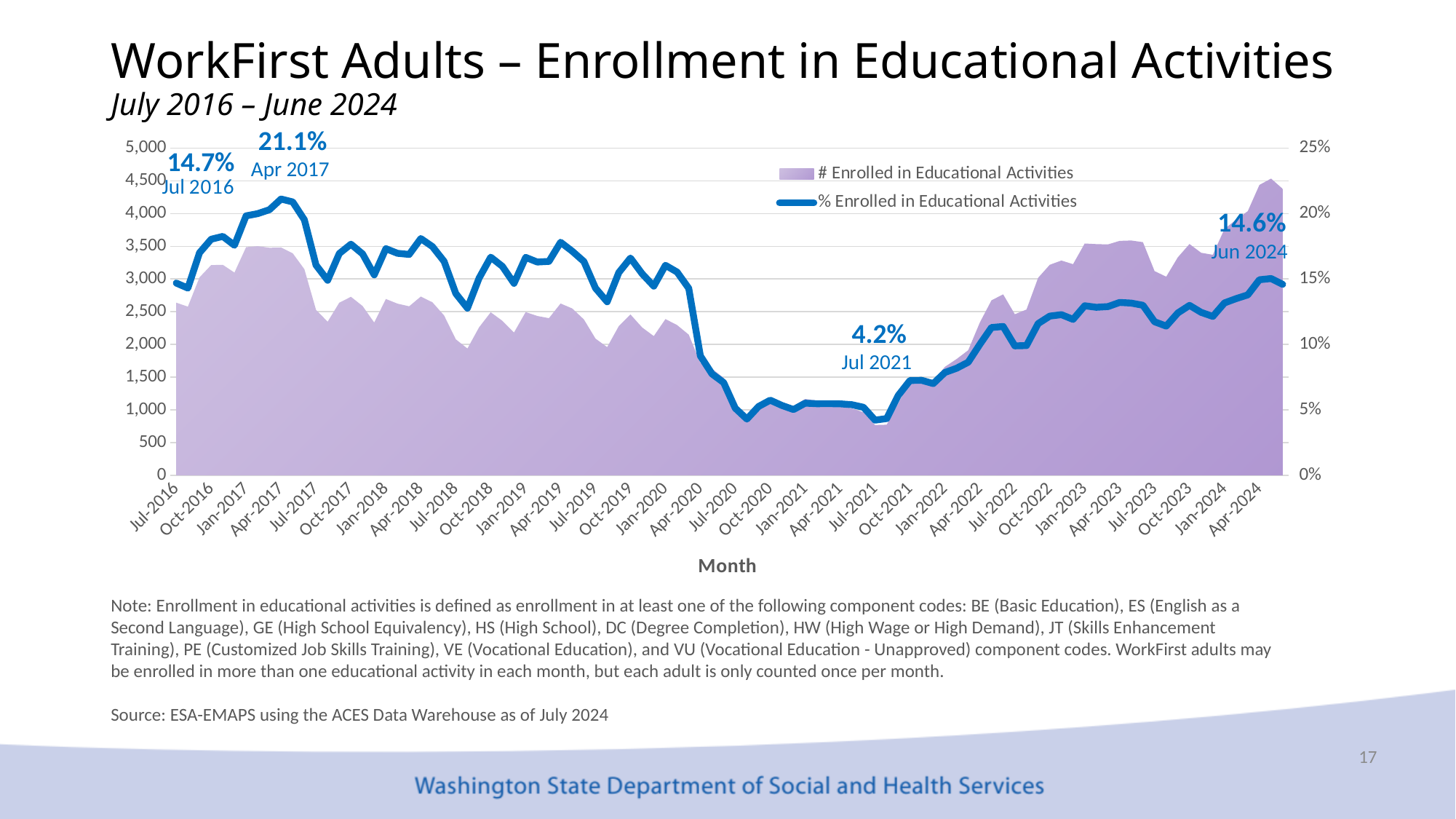
Did the percentage enrolled in educational activities rise or fall between July 2021 and June 2024? rise How many series does the legend list? 2 What was the percentage enrolled in educational activities in July 2021? 4.2% In which labeled month did the percentage enrolled in educational activities reach its lowest value? Jul 2021 What was the percentage enrolled in educational activities in June 2024? 14.6% Is the number enrolled in educational activities in January 2017 greater or less than 2,500? greater What is the difference in percentage points between the April 2017 and July 2021 enrollment percentages? 16.9 percentage points What was the percentage enrolled in educational activities in April 2017? 21.1% In which labeled month did the percentage enrolled in educational activities reach its highest value? Apr 2017 What was the percentage enrolled in educational activities in July 2016? 14.7% Is the number enrolled in educational activities in July 2021 greater or less than 1,500? less Which was higher, the percentage enrolled in July 2016 or in June 2024? July 2016